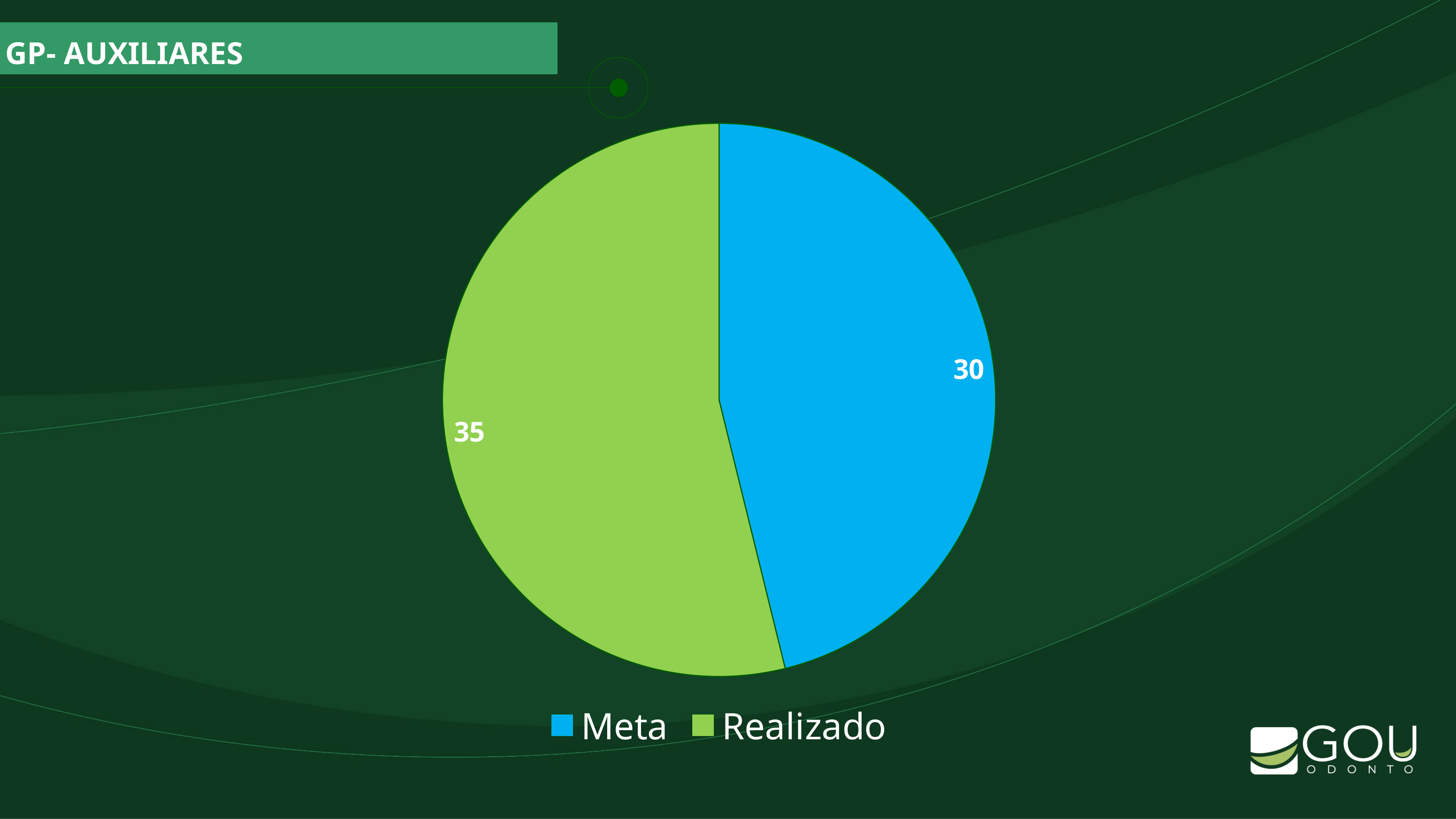
Which slice is the largest? Realizado What type of chart is shown on the slide? pie chart What is the value for Realizado? 35 How many slices does the pie chart have? 2 How many entries does the legend list? 2 Which is larger, Meta or Realizado? Realizado What is the total of all slices in the pie chart? 65 What colour is the Meta slice? blue What is the title shown at the top of the slide? GP- AUXILIARES What is the value for Meta? 30 What is the difference between Realizado and Meta? 5 Which slice is the smallest? Meta